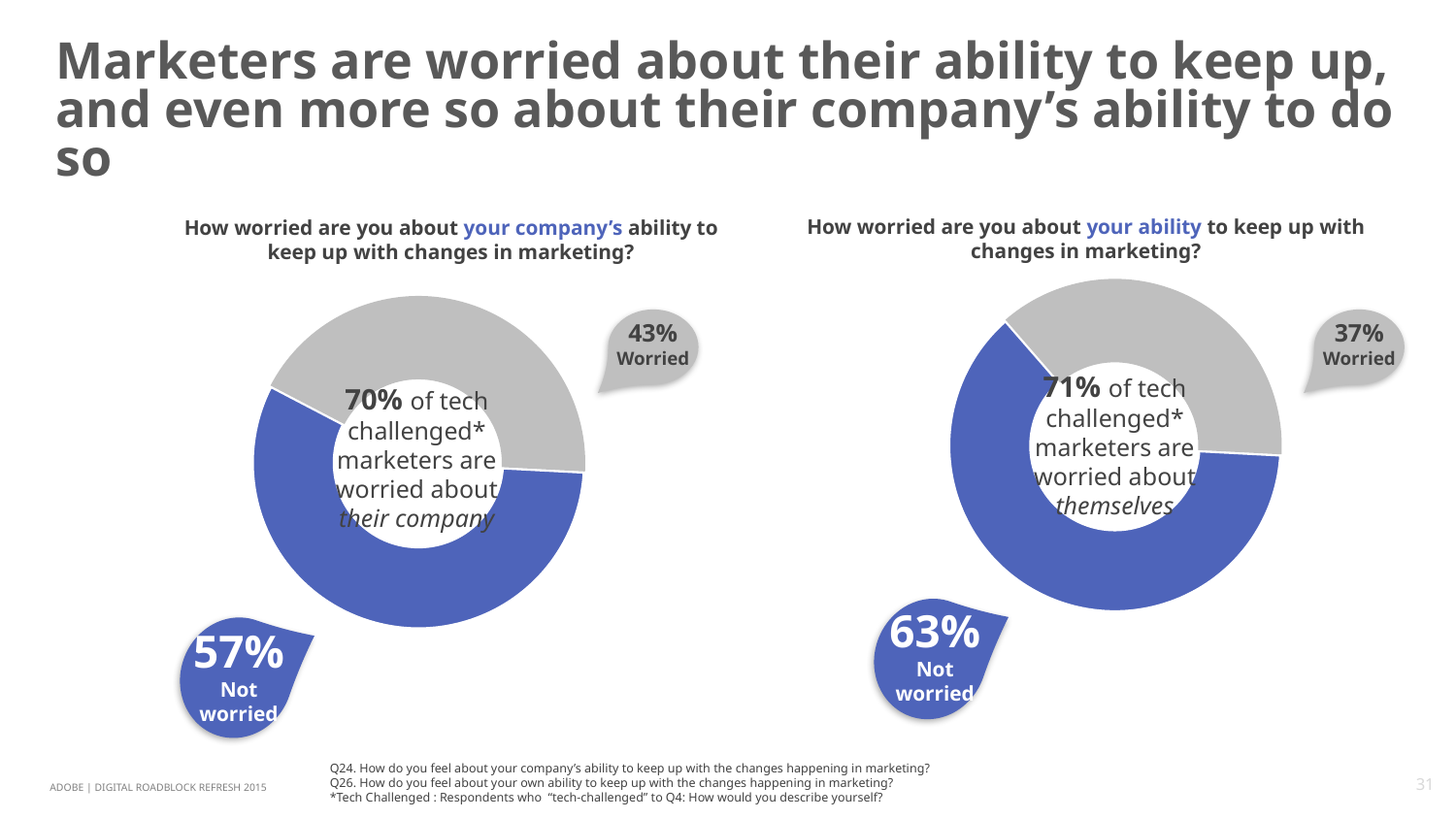
In the left chart about your company's ability to keep up, what is the difference in percentage points between Not worried and Worried? 14 In the right chart about your ability to keep up, what percentage of respondents are worried? 37% In the right chart about your ability to keep up, what is the difference in percentage points between Not worried and Worried? 26 In the left chart about your company's ability to keep up, which response has the larger share: Worried or Not worried? Not worried In the right chart about your ability to keep up, what colour is the Not worried slice? Blue Is the Worried share larger in the left chart (company's ability) or the right chart (your ability)? Left chart (company's ability) In the left chart about your company's ability to keep up, what percentage of respondents are worried? 43% In the right chart about your ability to keep up, which response has the smaller share? Worried In the right chart about your ability to keep up, what percentage of respondents are not worried? 63% In the left chart about your company's ability to keep up, what percentage of respondents are not worried? 57% How many slices does each donut chart on the slide have? 2 What type of chart is used on this slide? Donut (pie) chart